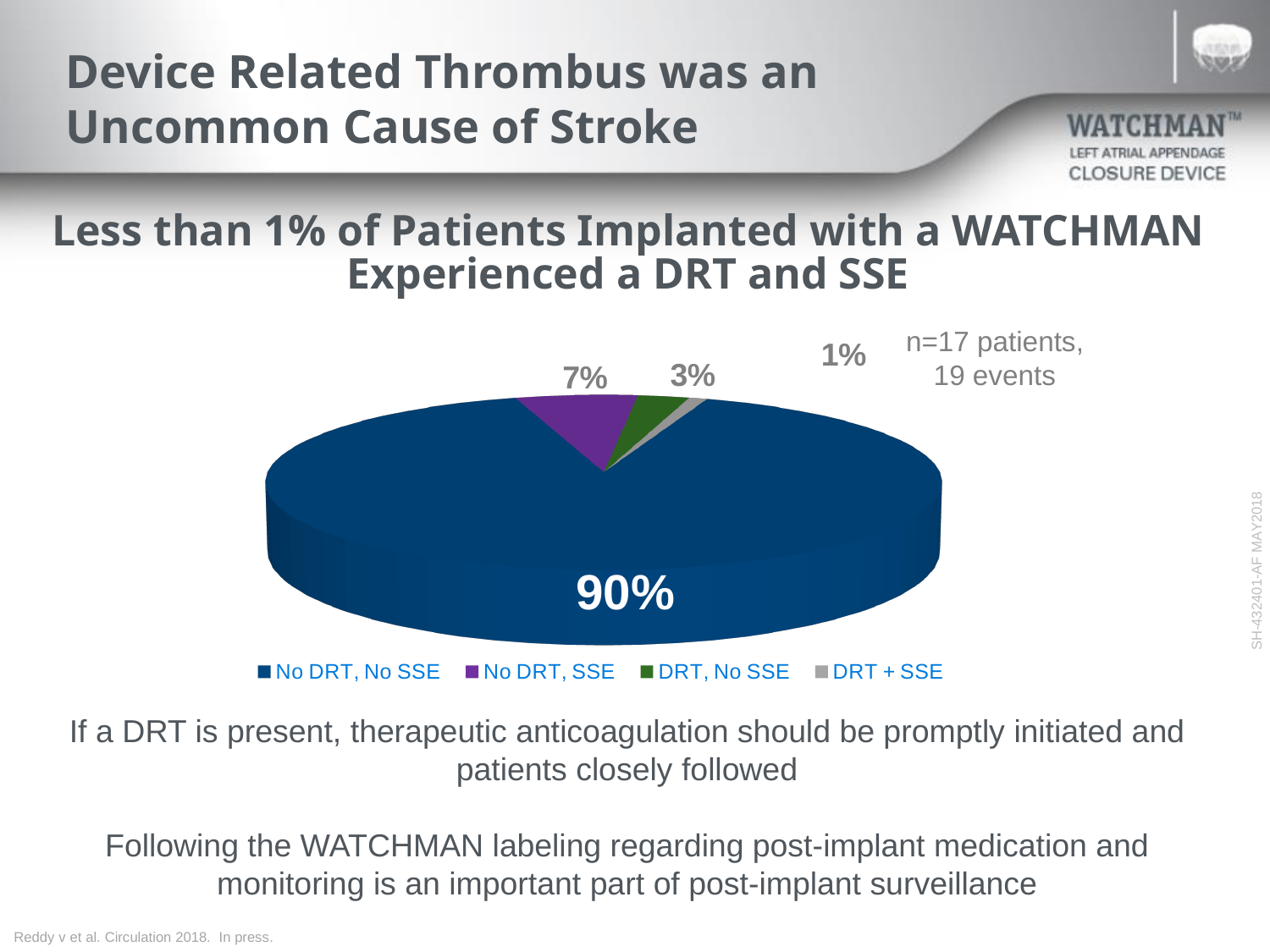
What is the difference in percentage points between the No DRT, No SSE slice and the No DRT, SSE slice? 83 What colour is the No DRT, No SSE slice in the pie chart? blue What kind of chart is shown on the slide? pie chart What percentage of patients had DRT + SSE? 1% What percentage of patients had No DRT, SSE? 7% Which category has the largest slice of the pie chart? No DRT, No SSE What percentage of patients had DRT, No SSE? 3% What percentage of patients had No DRT, No SSE? 90% How many slices does the pie chart have? 4 Which is larger: the No DRT, SSE slice or the DRT, No SSE slice? No DRT, SSE How many entries does the legend of the pie chart list? 4 Which category has the smallest slice of the pie chart? DRT + SSE